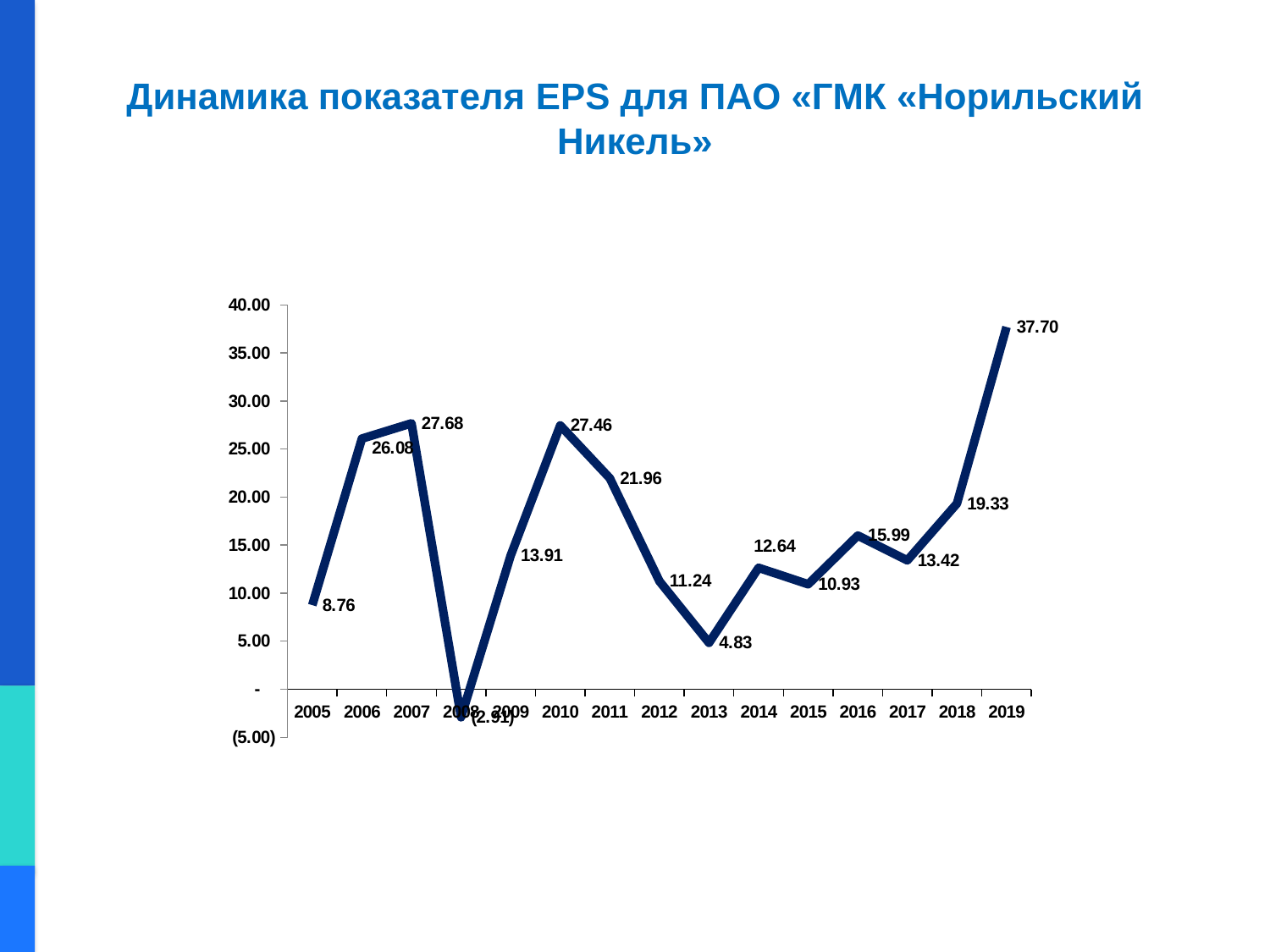
Do the EPS values rise or fall from 2010 to 2013? fall Which year has the highest EPS value? 2019 What is the difference between the EPS values for 2019 and 2018? 18.37 What is the EPS value for 2010? 27.46 What is the difference between the EPS values for 2010 and 2011? 5.50 What kind of chart is shown on the slide? line chart Which is larger, the EPS value for 2007 or for 2010? 2007 What is the EPS value for 2019? 37.70 What is the EPS value for 2005? 8.76 Which year has the lowest EPS value? 2008 How many years are plotted on the chart? 15 What is the EPS value for 2013? 4.83